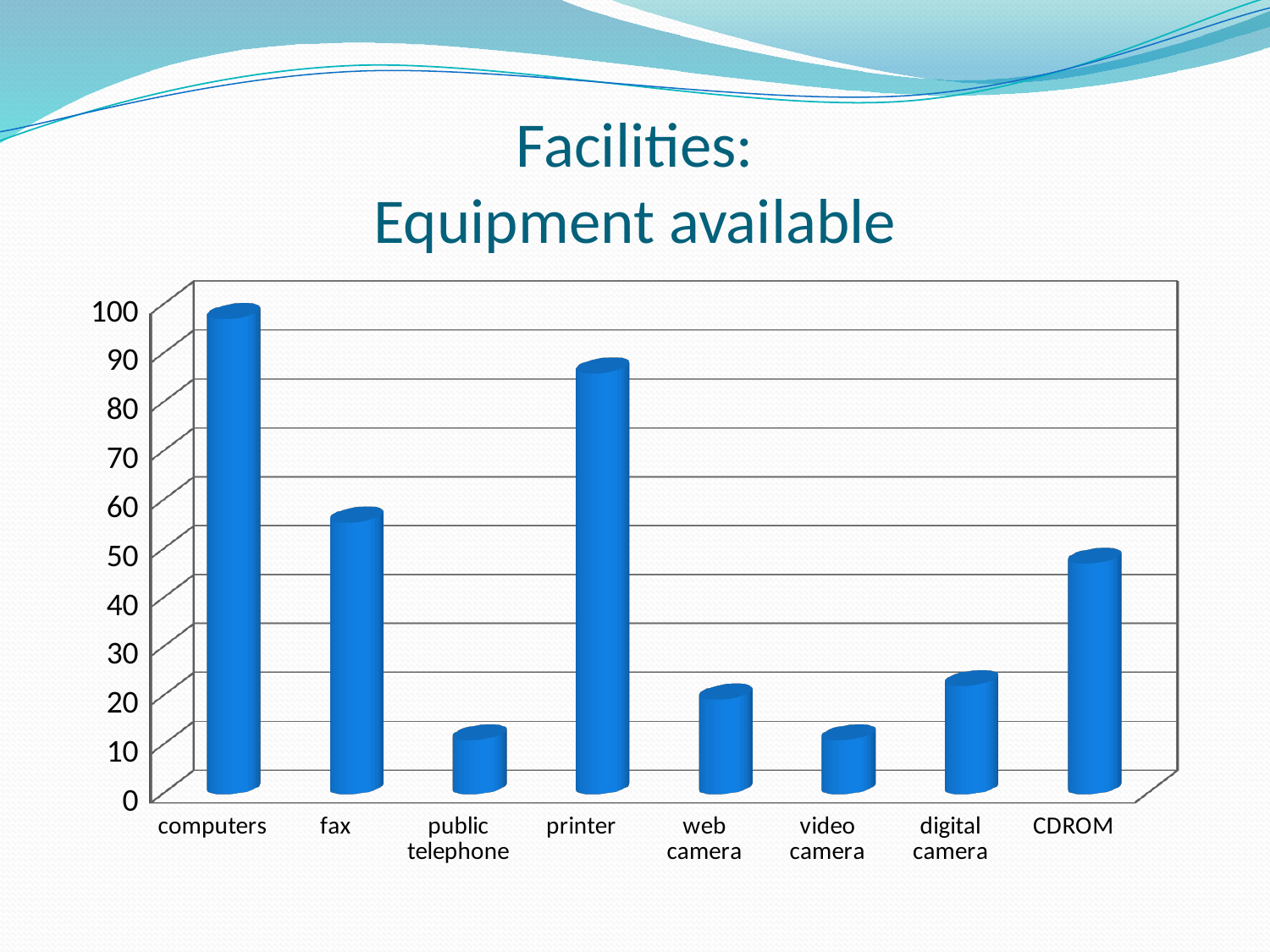
Which is larger, the value for CDROM or the value for web camera? CDROM Is the value for CDROM greater or less than 60? less What kind of chart is shown on the slide? bar chart Is the value for fax greater or less than 50? greater How many equipment categories are shown on the chart? 8 Is the value for public telephone greater or less than 20? less Which equipment category has the highest value? computers What is the title of the slide containing the chart? Facilities: Equipment available Which is larger, the value for printer or the value for fax? printer